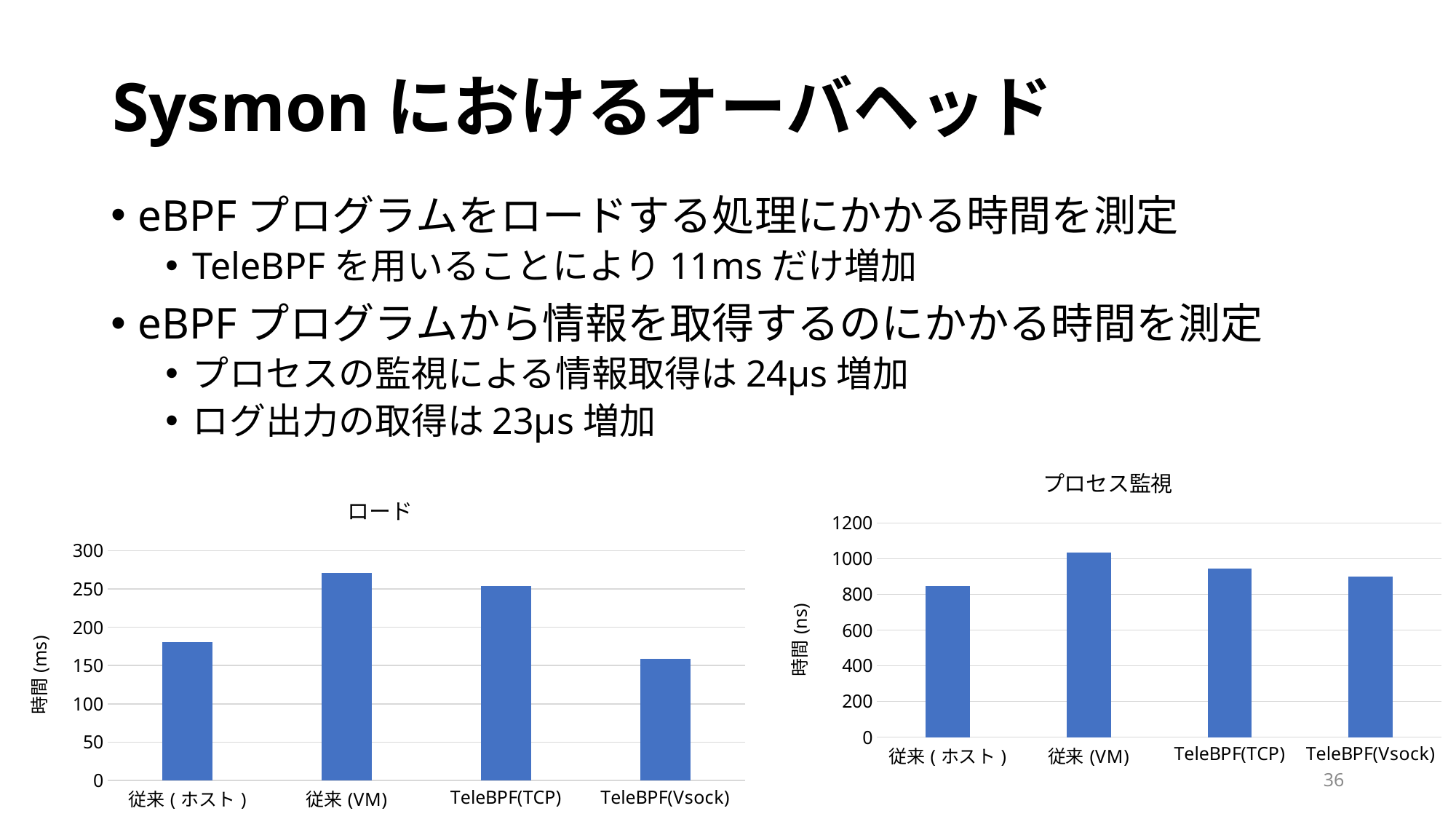
What kind of chart is the ロード chart? bar chart What is the y-axis label of the ロード chart? 時間 (ms) In the プロセス監視 chart, which category has the highest value? 従来 (VM) How many categories are shown in the ロード chart? 4 In the ロード chart, is the value for TeleBPF(Vsock) greater or less than 200? less In the ロード chart, which category has the highest value? 従来 (VM) What is the y-axis label of the プロセス監視 chart? 時間 (ns) In the プロセス監視 chart, which category has the lowest value? 従来 ( ホスト ) In the プロセス監視 chart, is the value for 従来 (VM) greater or less than 1000? greater In the ロード chart, is the value for 従来 (VM) greater or less than 250? greater In the ロード chart, which is larger: 従来 ( ホスト ) or TeleBPF(TCP)? TeleBPF(TCP) In the ロード chart, which category has the lowest value? TeleBPF(Vsock)